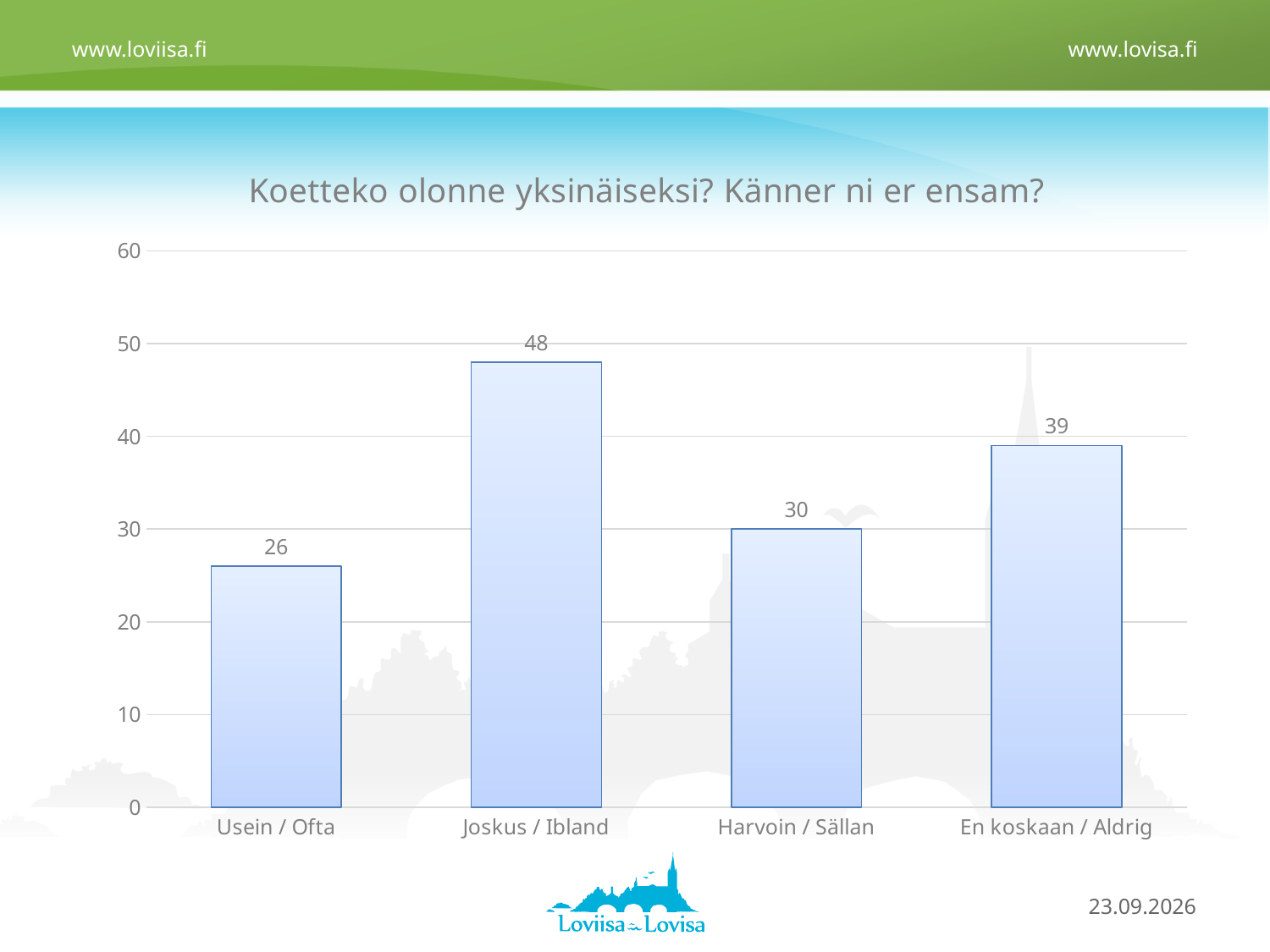
Which category has the highest value? Joskus / Ibland What is the difference between the values for Joskus / Ibland and Harvoin / Sällan? 18 Which is larger, the value for Harvoin / Sällan or the value for En koskaan / Aldrig? En koskaan / Aldrig What is the value for En koskaan / Aldrig? 39 What is the difference between the values for En koskaan / Aldrig and Usein / Ofta? 13 What is the title of the chart? Koetteko olonne yksinäiseksi? Känner ni er ensam? What kind of chart is shown on the slide? bar chart How many categories are shown on the x axis? 4 Which category has the lowest value? Usein / Ofta Is the value for Harvoin / Sällan greater or less than 40? less What is the value for Usein / Ofta? 26 What is the value for Joskus / Ibland? 48